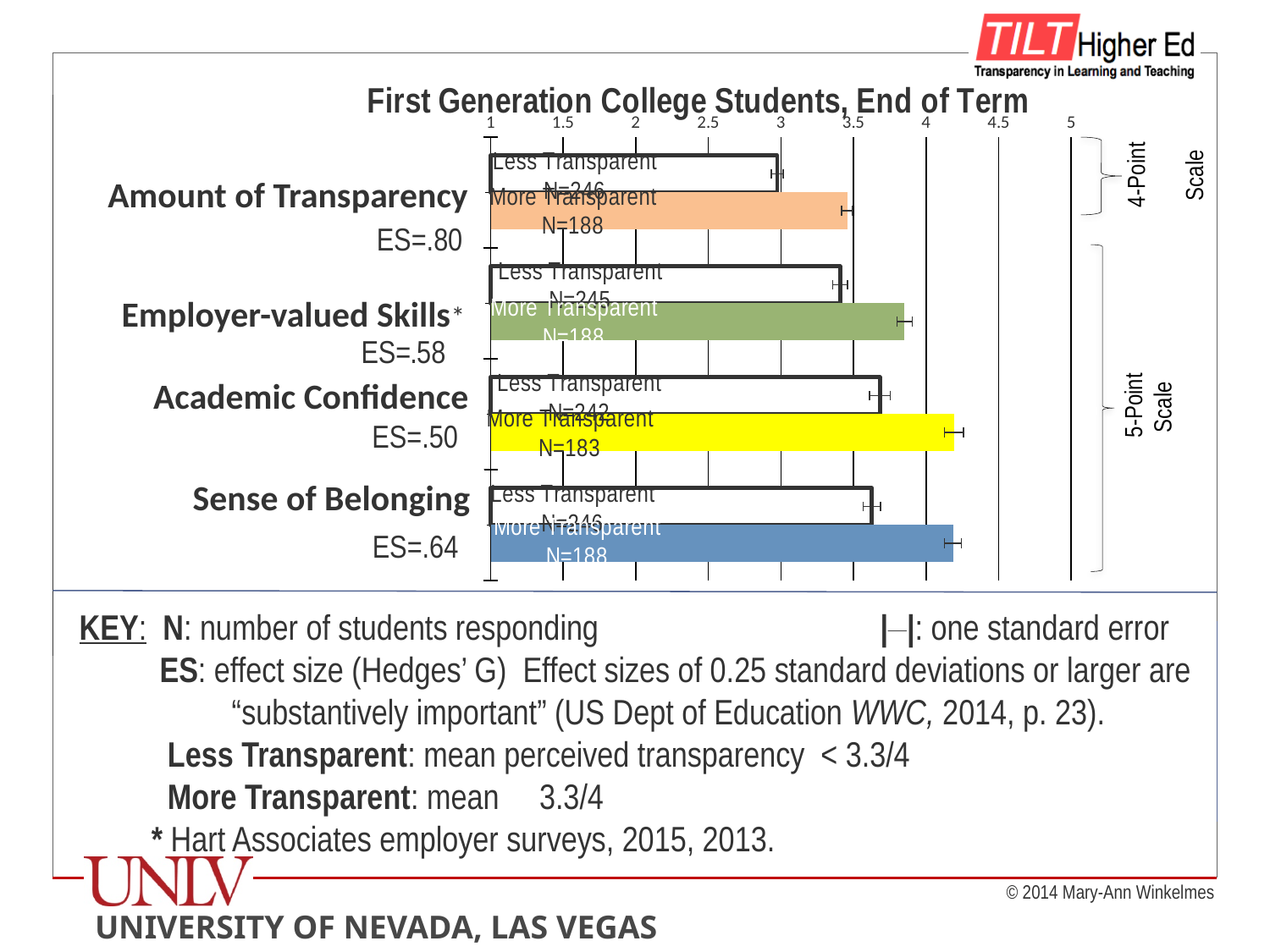
For Sense of Belonging, which bar is longer: Less Transparent or More Transparent? More Transparent Is the Less Transparent bar for Amount of Transparency greater or less than 3.5? less What is the title of the chart? First Generation College Students, End of Term Is the More Transparent bar for Academic Confidence greater or less than 4? greater What kind of chart is shown on the slide? bar chart What is the effect size (ES) shown for Academic Confidence? ES=.50 Which category has the smallest effect size (ES)? Academic Confidence How many outcome categories are plotted on the chart? 4 What is the effect size (ES) shown for Amount of Transparency? ES=.80 Which category has the largest effect size (ES)? Amount of Transparency What is the difference between the effect sizes for Amount of Transparency and Academic Confidence? .30 What is the N for the More Transparent group in Academic Confidence? N=183